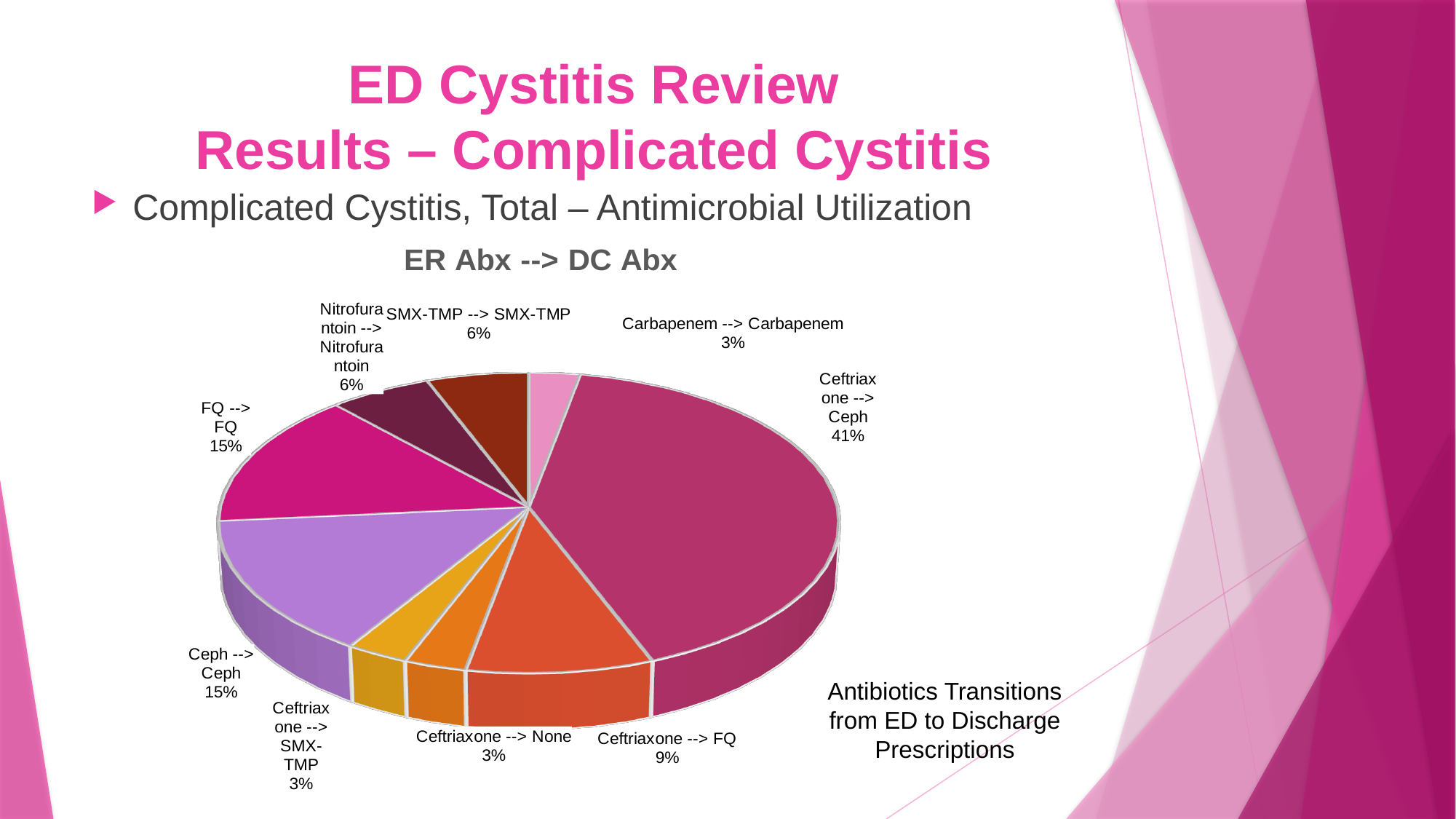
What percentage of the pie is the Ceftriaxone --> Ceph slice? 41% What percentage is shown for FQ --> FQ? 15% What percentage is shown for Nitrofurantoin --> Nitrofurantoin? 6% How many slices does the pie chart have? 9 What percentage is shown for Carbapenem --> Carbapenem? 3% What type of chart is shown on the slide? Pie chart What is the title of the chart? ER Abx --> DC Abx Which is larger, the share for Ceph --> Ceph or the share for SMX-TMP --> SMX-TMP? Ceph --> Ceph What percentage is shown for Ceftriaxone --> FQ? 9% What is the difference in percentage points between Ceftriaxone --> Ceph and Ceftriaxone --> FQ? 32 Which transition has the largest share of the pie? Ceftriaxone --> Ceph What is the difference in percentage points between FQ --> FQ and Nitrofurantoin --> Nitrofurantoin? 9